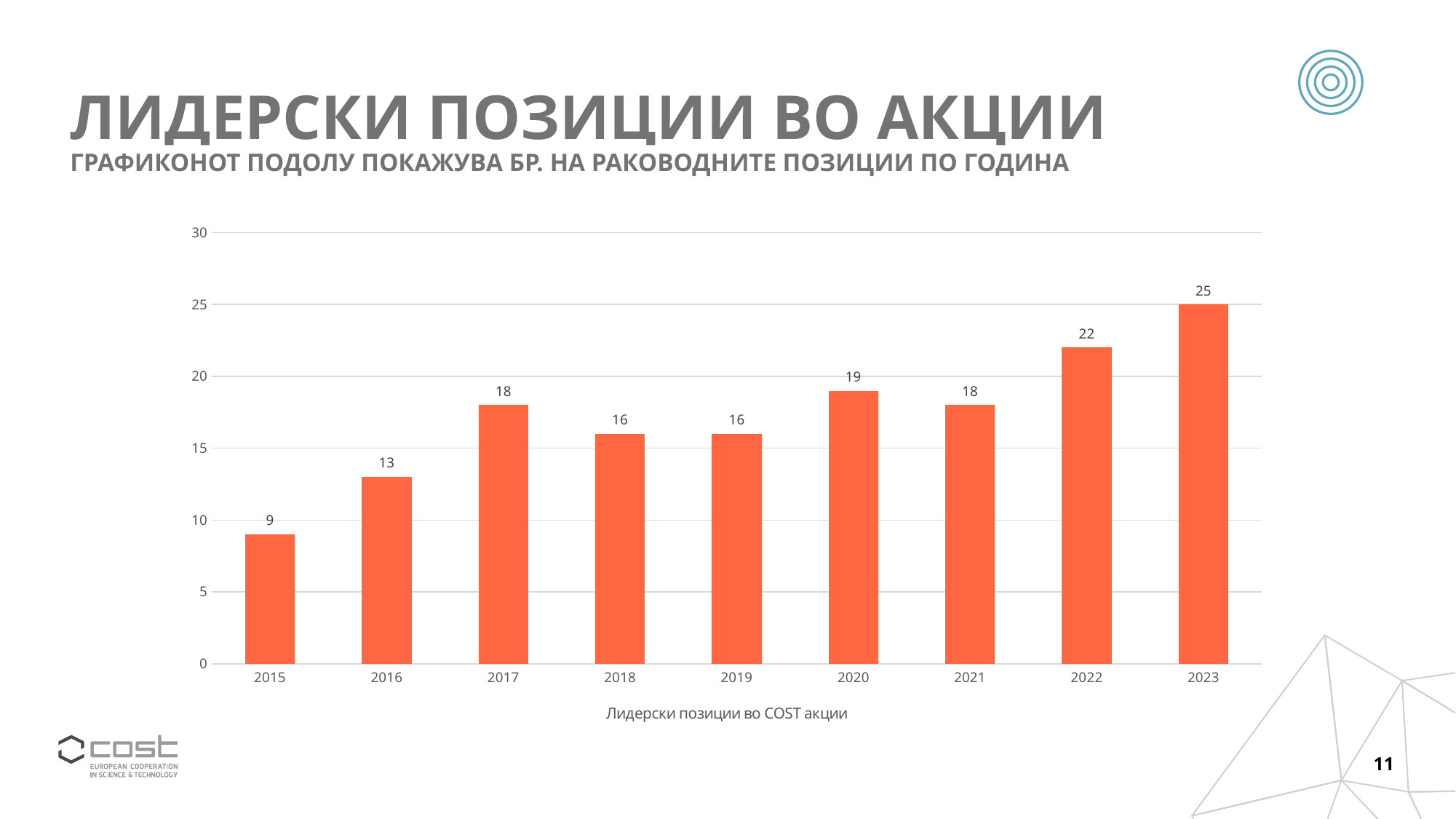
How many years are shown on the x axis? 9 What is the legend entry shown below the chart? Лидерски позиции во COST акции What kind of chart is shown on the slide? bar chart What is the value for 2022? 22 What is the difference between the values for 2023 and 2015? 16 What is the value for 2020? 19 What is the value for 2015? 9 Which year has the lowest value? 2015 Which is larger, the value for 2017 or the value for 2018? 2017 Which year has the highest value? 2023 Is the value for 2016 greater or less than 15? less What is the difference between the values for 2022 and 2021? 4